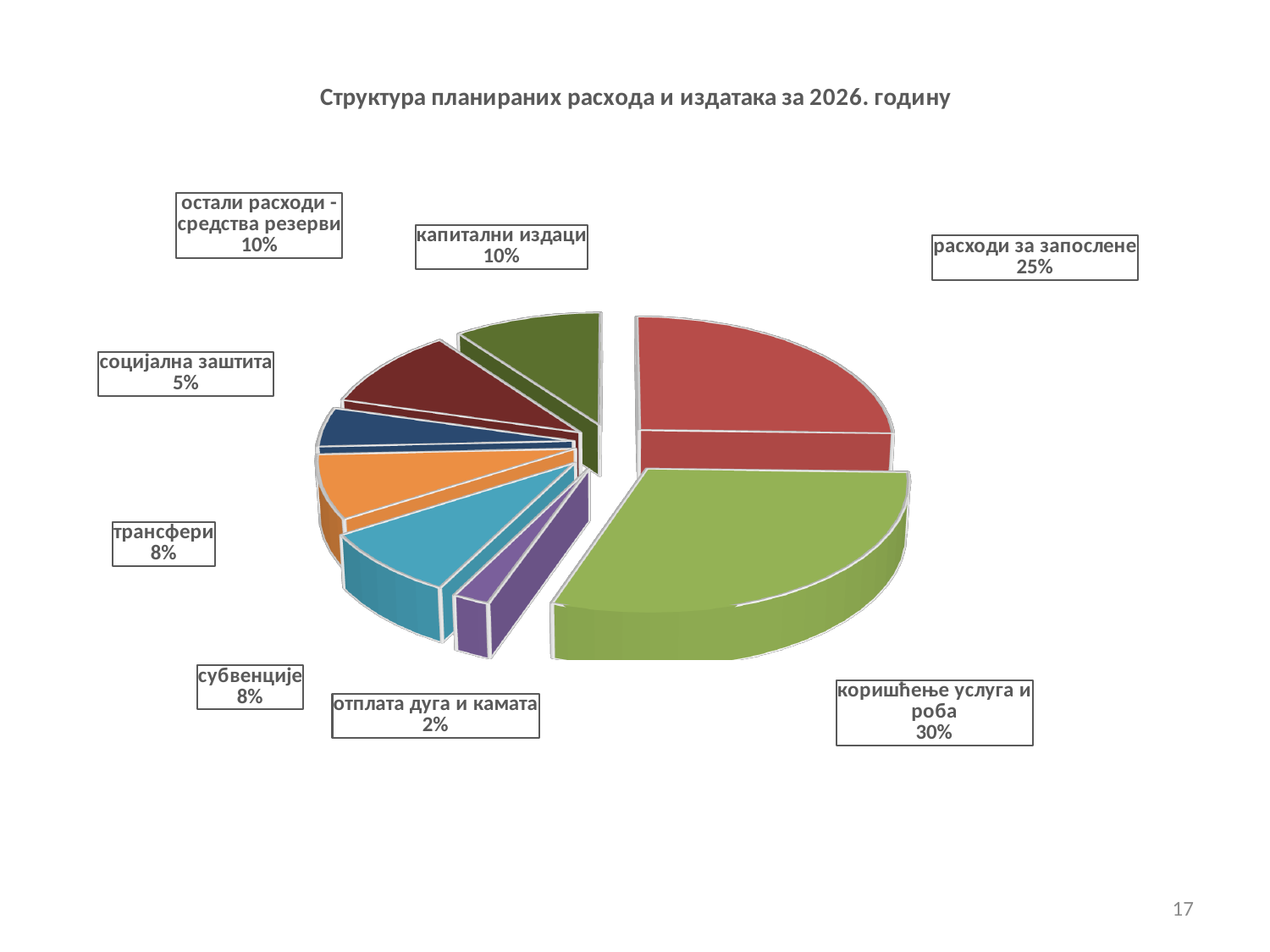
What is the difference between the shares of 'коришћење услуга и роба' and 'расходи за запослене'? 5% What share of the pie is 'расходи за запослене'? 25% Which category has the smallest share of the pie? отплата дуга и камата Which is larger, the share for 'трансфери' or the share for 'социјална заштита'? трансфери What is the title of the chart? Структура планираних расхода и издатака за 2026. годину What is the value shown for 'капитални издаци'? 10% How many categories (slices) does the pie chart have? 8 Which category has the largest share of the pie? коришћење услуга и роба What kind of chart is shown on the slide? pie chart What share of the pie is 'коришћење услуга и роба'? 30% What is the value shown for 'социјална заштита'? 5% What is the value shown for 'отплата дуга и камата'? 2%